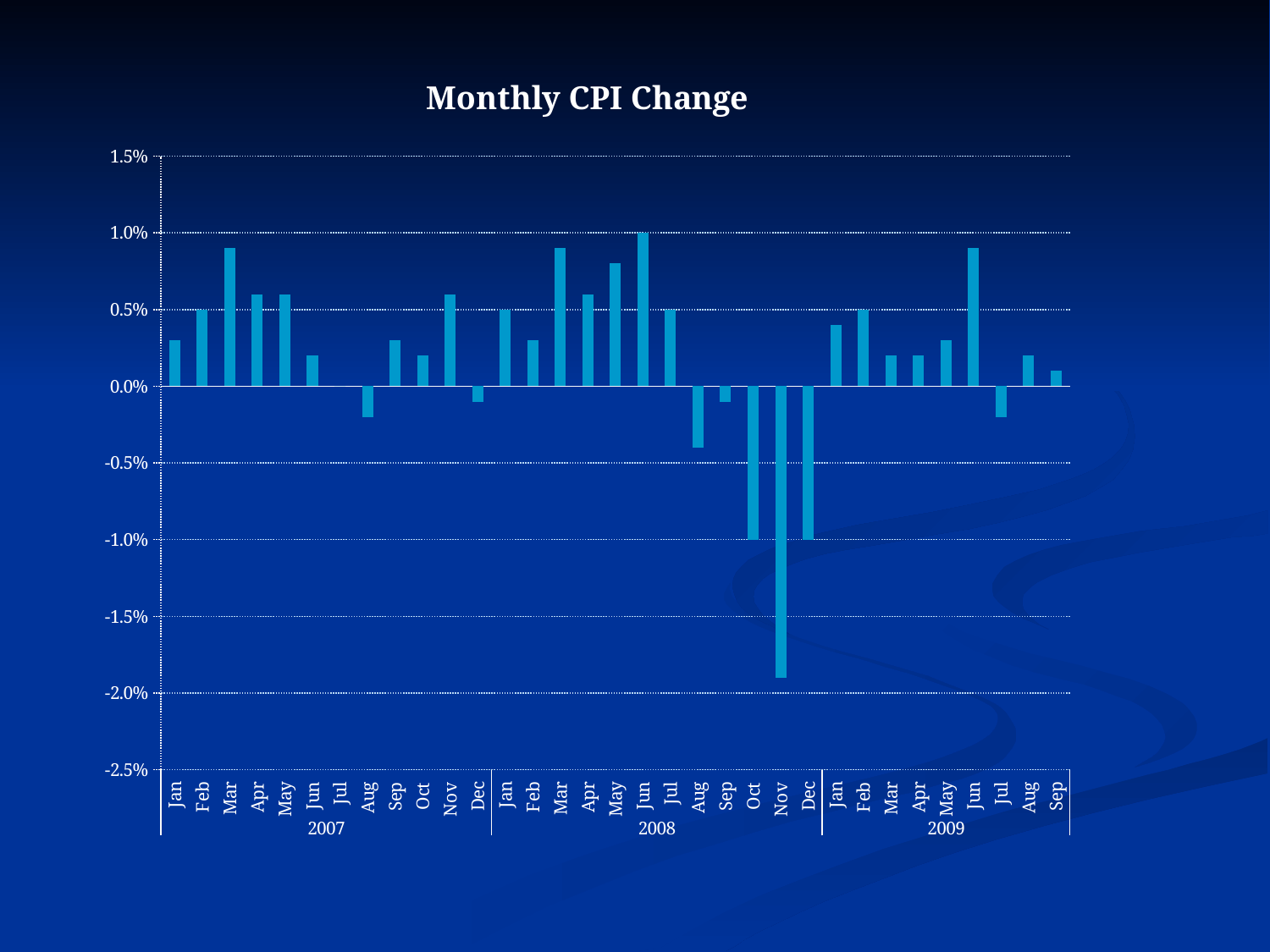
What is the title of the chart? Monthly CPI Change Is the value for Mar 2007 greater or less than 0.5%? greater What kind of chart is shown on the slide? bar chart Is the value for Nov 2008 greater or less than -1.5%? less Which is larger, the value for Mar 2008 or the value for Feb 2008? Mar 2008 Which years are shown on the x axis? 2007, 2008, 2009 Which month has the lowest monthly CPI change? Nov 2008 What is the monthly CPI change for Oct 2008? -1.0% Is the value for Aug 2008 greater or less than -0.5%? greater How many months are plotted on the chart? 33 What is the monthly CPI change for Jun 2008? 1.0% Which month has the highest monthly CPI change? Jun 2008